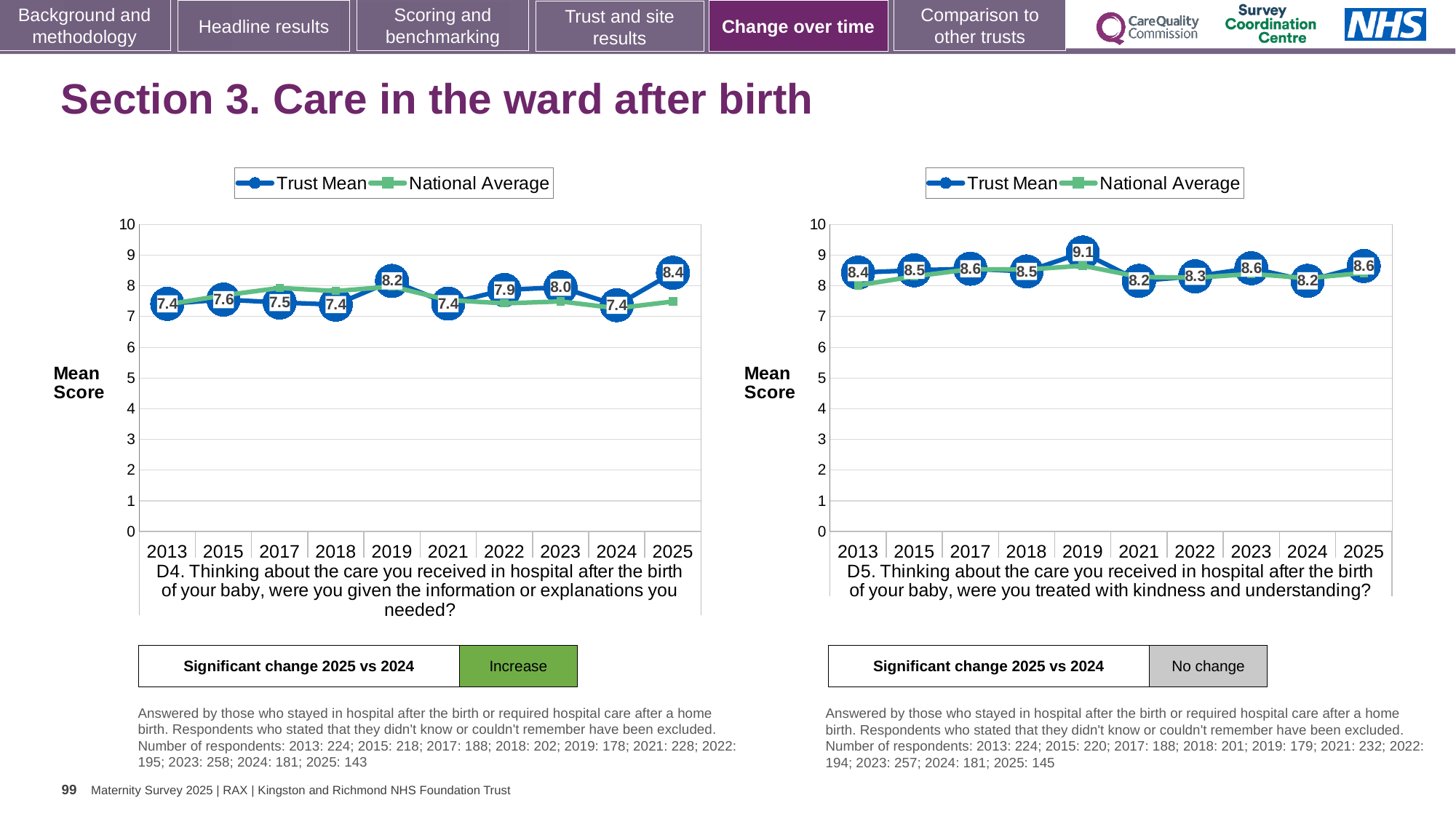
In the D5 chart on the right, what is the difference between the Trust Mean for 2019 and the Trust Mean for 2021? 0.9 In the D4 chart on the left, what is the Trust Mean for 2025? 8.4 What kind of chart is the D4 chart on the left? line chart In the D5 chart on the right, what is the Trust Mean for 2024? 8.2 In the D5 chart on the right, which year has the highest Trust Mean? 2019 How many years are plotted on the x axis of the D5 chart on the right? 10 In the D4 chart on the left, is the Trust Mean for 2023 higher or lower than the Trust Mean for 2022? higher How many series does the legend of the D4 chart on the left list? 2 In the D5 chart on the right, what is the Trust Mean for 2019? 9.1 In the D4 chart on the left, what is the Trust Mean for 2019? 8.2 In the D4 chart on the left, which year has the highest Trust Mean? 2025 In the D4 chart on the left, what is the difference between the Trust Mean for 2025 and the Trust Mean for 2024? 1.0